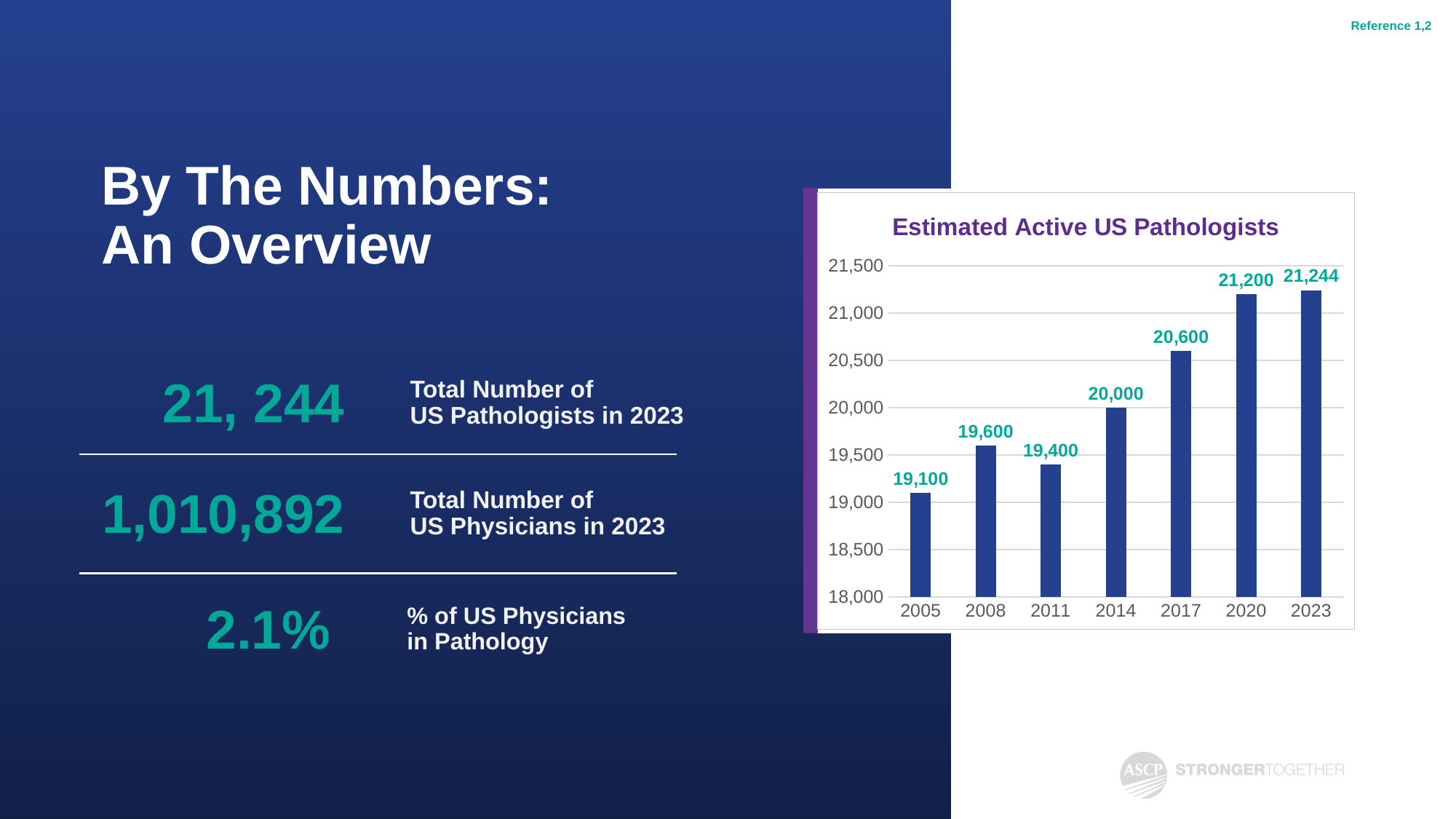
How many years are shown on the x axis of the chart? 7 What is the estimated number of active US pathologists in 2005? 19,100 Which year has the highest estimated number of active US pathologists? 2023 What is the estimated number of active US pathologists in 2017? 20,600 What is the difference between the estimated number of active US pathologists in 2008 and in 2011? 200 Which year has more estimated active US pathologists, 2008 or 2011? 2008 Which year has the lowest estimated number of active US pathologists? 2005 What is the difference between the estimated number of active US pathologists in 2023 and in 2005? 2,144 Between 2014 and 2023, do the estimated numbers of active US pathologists rise or fall? Rise What is the title of the chart on the slide? Estimated Active US Pathologists What kind of chart is used to show the estimated active US pathologists? Bar chart What is the estimated number of active US pathologists in 2011? 19,400